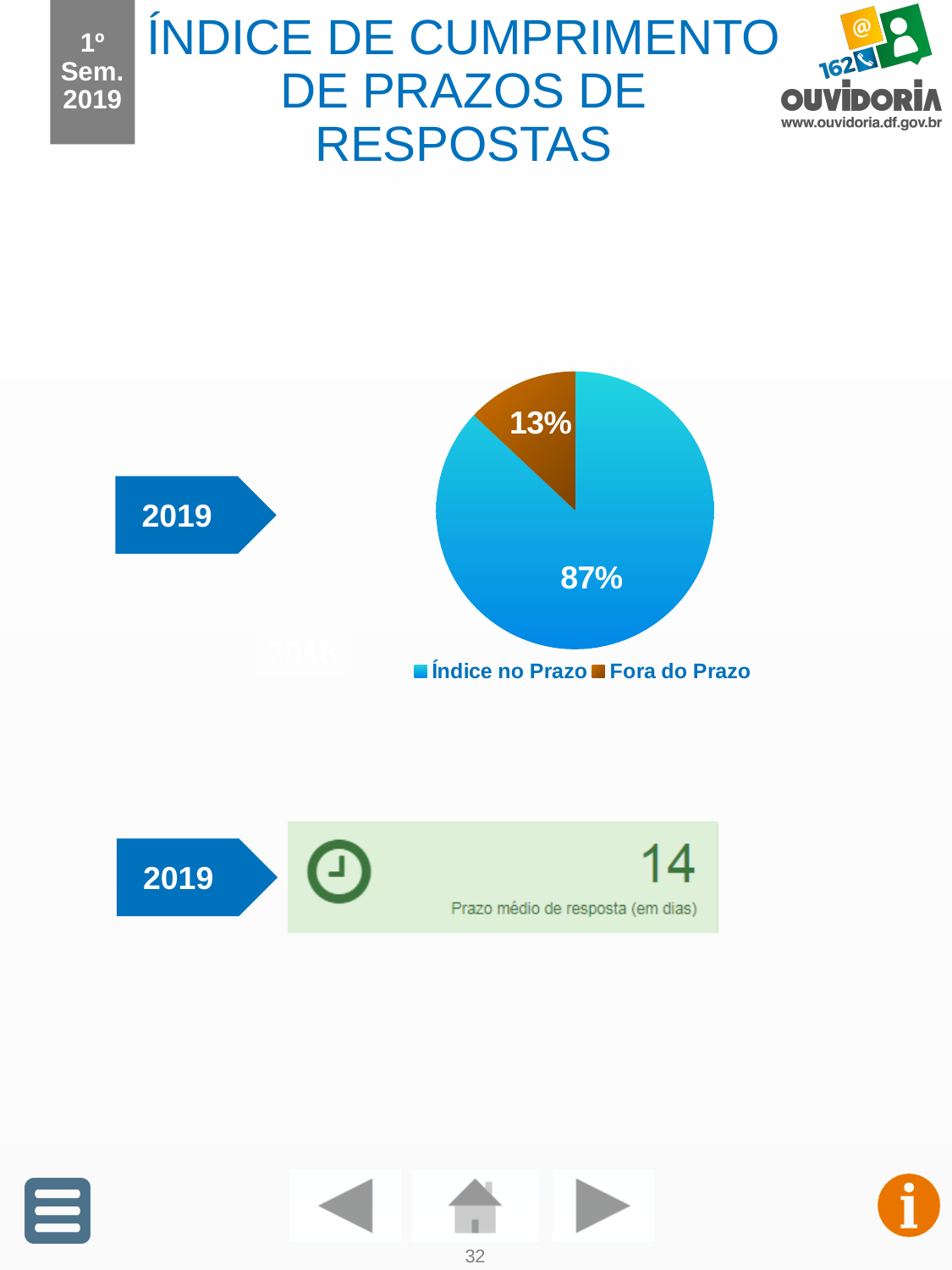
What colour is the Fora do Prazo slice in the pie chart? brown What percentage does the pie chart show for Fora do Prazo? 13% How many slices does the pie chart have? 2 Which slice of the pie chart is the largest? Índice no Prazo What percentage does the pie chart show for Índice no Prazo? 87% Which slice of the pie chart is the smallest? Fora do Prazo Which year label is shown next to the pie chart? 2019 What kind of chart is shown on the slide? pie chart Which is larger in the pie chart, Índice no Prazo or Fora do Prazo? Índice no Prazo How many entries does the pie chart legend list? 2 What share of the pie does the Fora do Prazo slice represent? 13% What is the difference in percentage points between Índice no Prazo and Fora do Prazo? 74